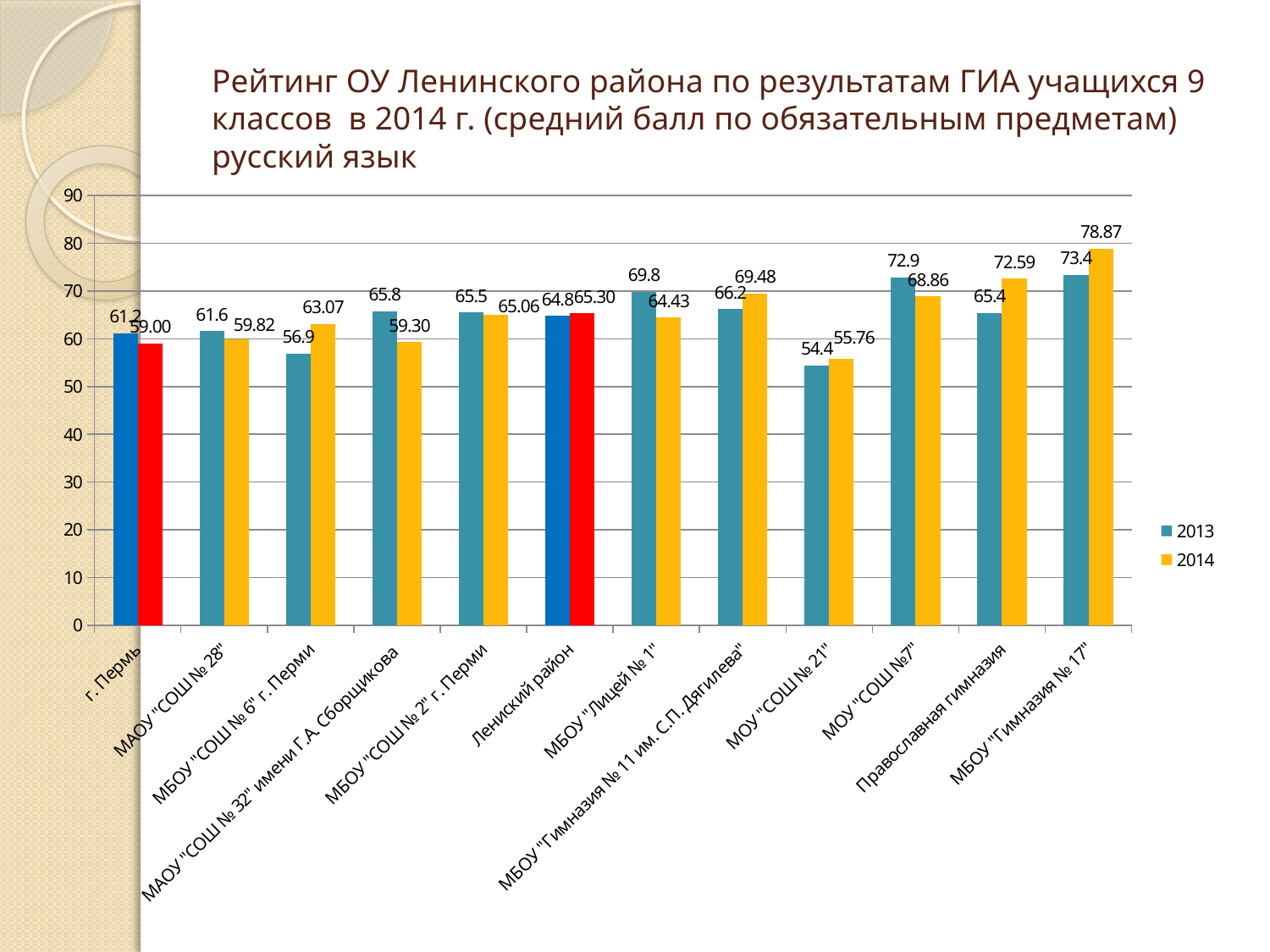
What is the difference between the 2014 and 2013 values for МБОУ "Гимназия № 17"? 5.47 What is the 2013 value for МОУ "СОШ №7"? 72.9 What is the 2014 value for МБОУ "Гимназия № 17"? 78.87 Which category has the lowest 2013 value? МОУ "СОШ № 21" Which category has the highest 2014 value? МБОУ "Гимназия № 17" What is the 2014 value for Ленинский район? 65.30 How many categories are shown on the x axis? 12 How many series does the legend list? 2 Which is larger for МБОУ "СОШ № 6" г. Перми: the 2013 value or the 2014 value? 2014 What kind of chart is shown on the slide? bar chart Is the 2013 value for МОУ "СОШ № 21" greater or less than 60? less What are the two series listed in the legend? 2013 and 2014